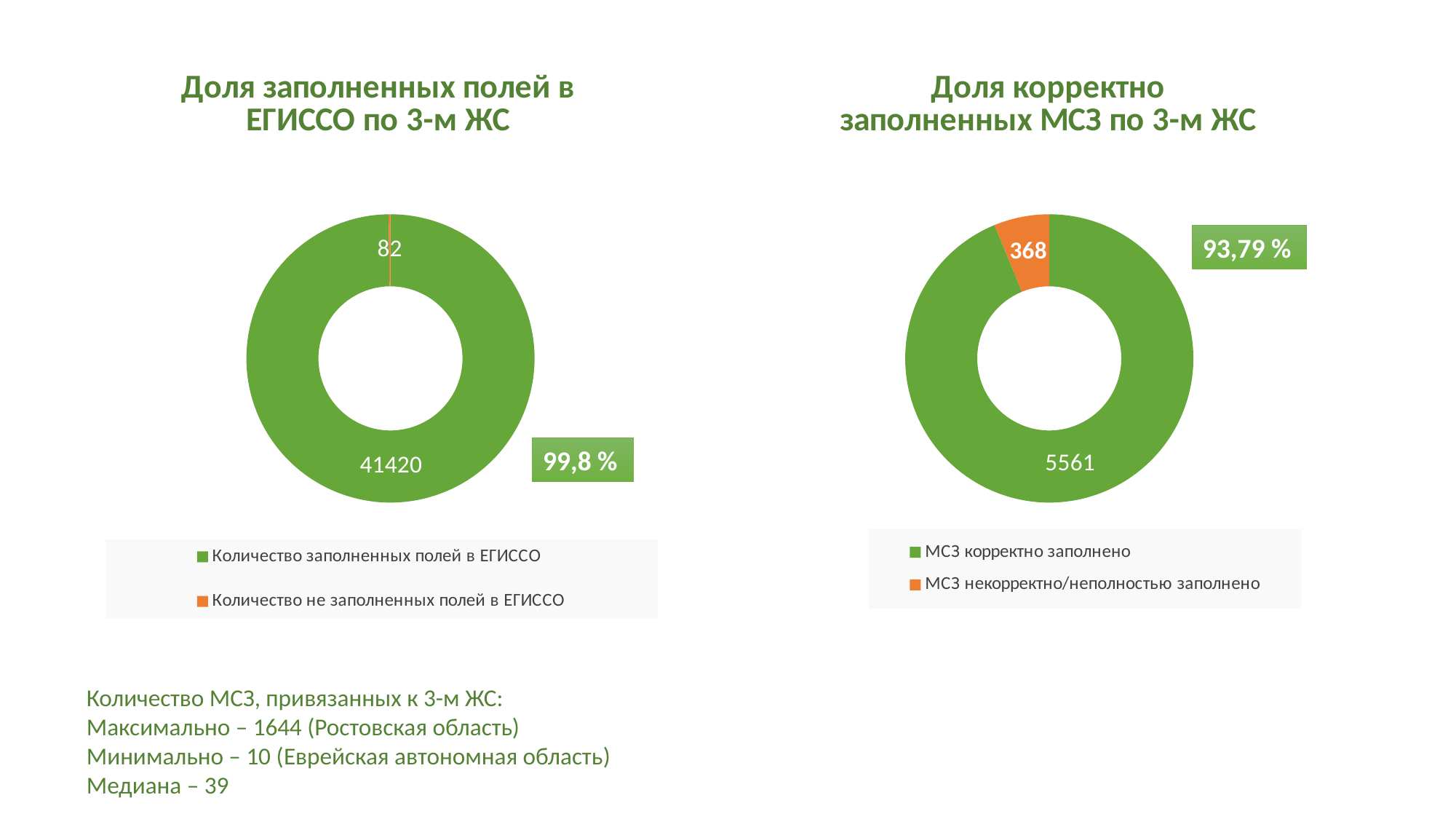
In the chart titled 'Доля заполненных полей в ЕГИССО по 3-м ЖС', what is the value for 'Количество не заполненных полей в ЕГИССО'? 82 In the chart titled 'Доля корректно заполненных МСЗ по 3-м ЖС', which category has the largest value? МСЗ корректно заполнено In the chart titled 'Доля заполненных полей в ЕГИССО по 3-м ЖС', what is the total of the two categories? 41502 In the chart titled 'Доля корректно заполненных МСЗ по 3-м ЖС', what is the value for 'МСЗ некорректно/неполностью заполнено'? 368 In the chart titled 'Доля заполненных полей в ЕГИССО по 3-м ЖС', which category has the smallest value? Количество не заполненных полей в ЕГИССО In the chart titled 'Доля корректно заполненных МСЗ по 3-м ЖС', what is the value for 'МСЗ корректно заполнено'? 5561 In the chart titled 'Доля заполненных полей в ЕГИССО по 3-м ЖС', what share is shown for the filled fields? 99,8 % What type of chart is the one on the right of the slide, titled 'Доля корректно заполненных МСЗ по 3-м ЖС'? Doughnut (pie) chart In the chart titled 'Доля заполненных полей в ЕГИССО по 3-м ЖС', what is the value for 'Количество заполненных полей в ЕГИССО'? 41420 How many categories does the legend of the chart titled 'Доля заполненных полей в ЕГИССО по 3-м ЖС' list? 2 In the chart titled 'Доля корректно заполненных МСЗ по 3-м ЖС', what is the difference between 'МСЗ корректно заполнено' and 'МСЗ некорректно/неполностью заполнено'? 5193 In the chart titled 'Доля корректно заполненных МСЗ по 3-м ЖС', what share of the total is shown for the correctly filled МСЗ? 93,79 %